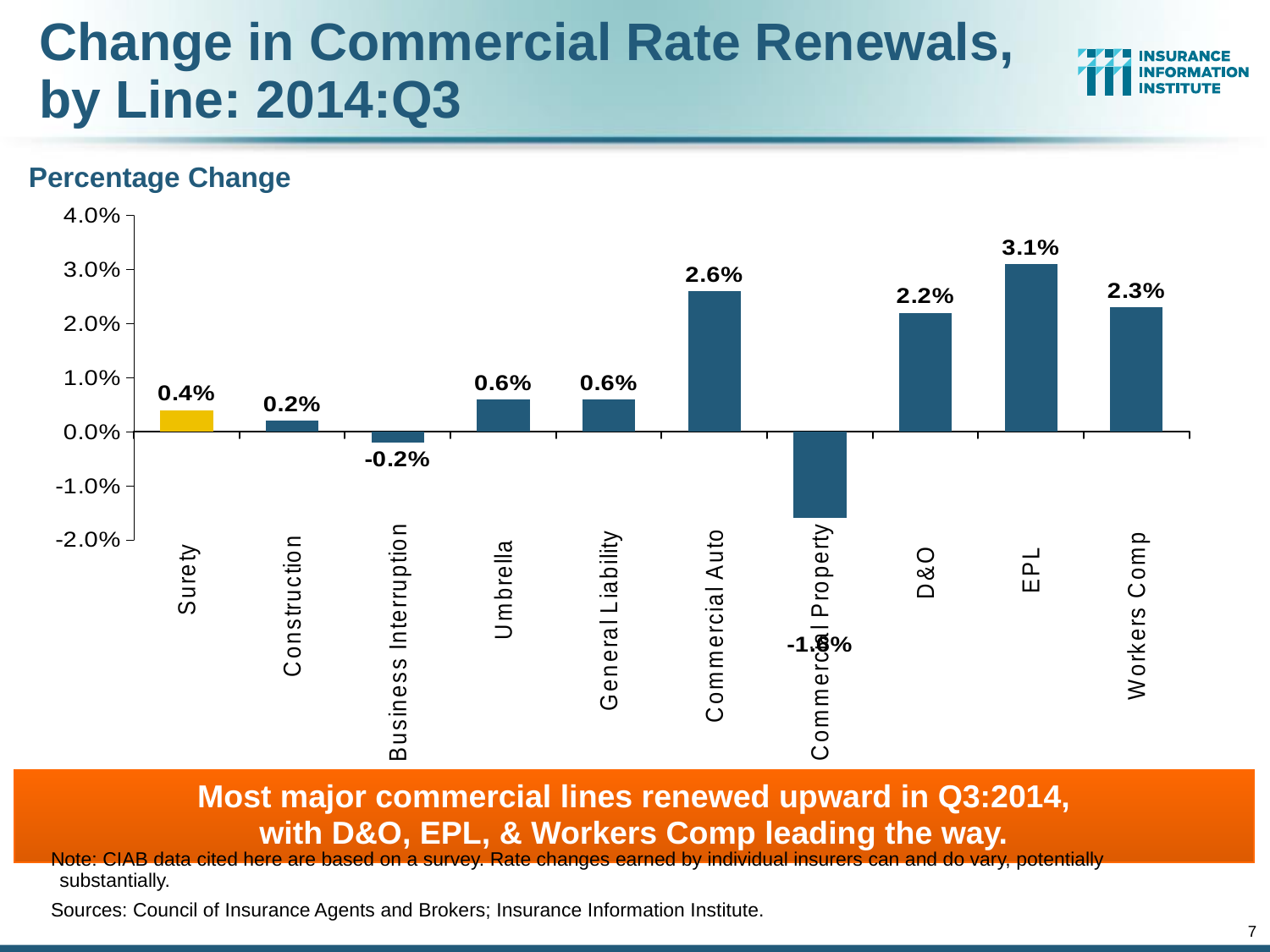
Which line has the highest percentage change? EPL What is the difference between the percentage change for EPL and for Workers Comp? 0.8% How many lines are shown on the chart? 10 What is the percentage change for Business Interruption? -0.2% What is the percentage change for EPL? 3.1% Which has a larger percentage change, D&O or Workers Comp? Workers Comp What is the percentage change for Commercial Auto? 2.6% Which bar is coloured differently (yellow) from the others? Surety Which line has the lowest percentage change? Commercial Property What is the percentage change for Surety? 0.4% Is the value for Commercial Property greater or less than -1.0%? less What kind of chart is shown on the slide? Bar chart